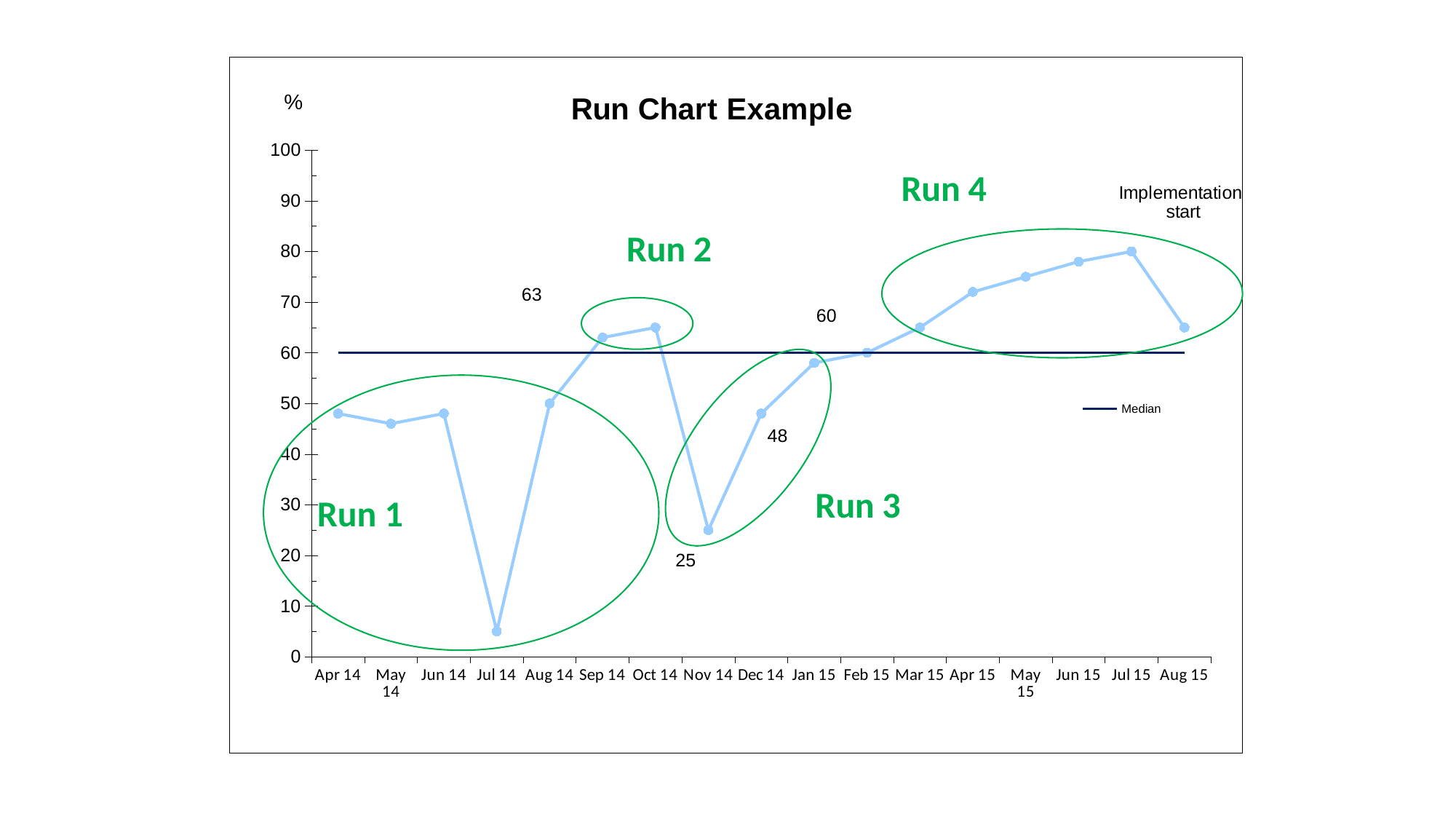
What kind of chart is shown on the slide? line chart What is the value for Feb 15? 60 What is the value for Sep 14? 63 What is the difference between the values for Dec 14 and Nov 14? 23 Is the value for Jun 15 greater or less than 70? greater Do the values rise or fall from Apr 15 to Jul 15? rise Is the value for Jul 14 greater or less than 10? less What is the value for Nov 14? 25 Which month has the lowest value? Jul 14 Which month has the highest value? Jul 15 What is the value for Dec 14? 48 What is the title of the chart? Run Chart Example